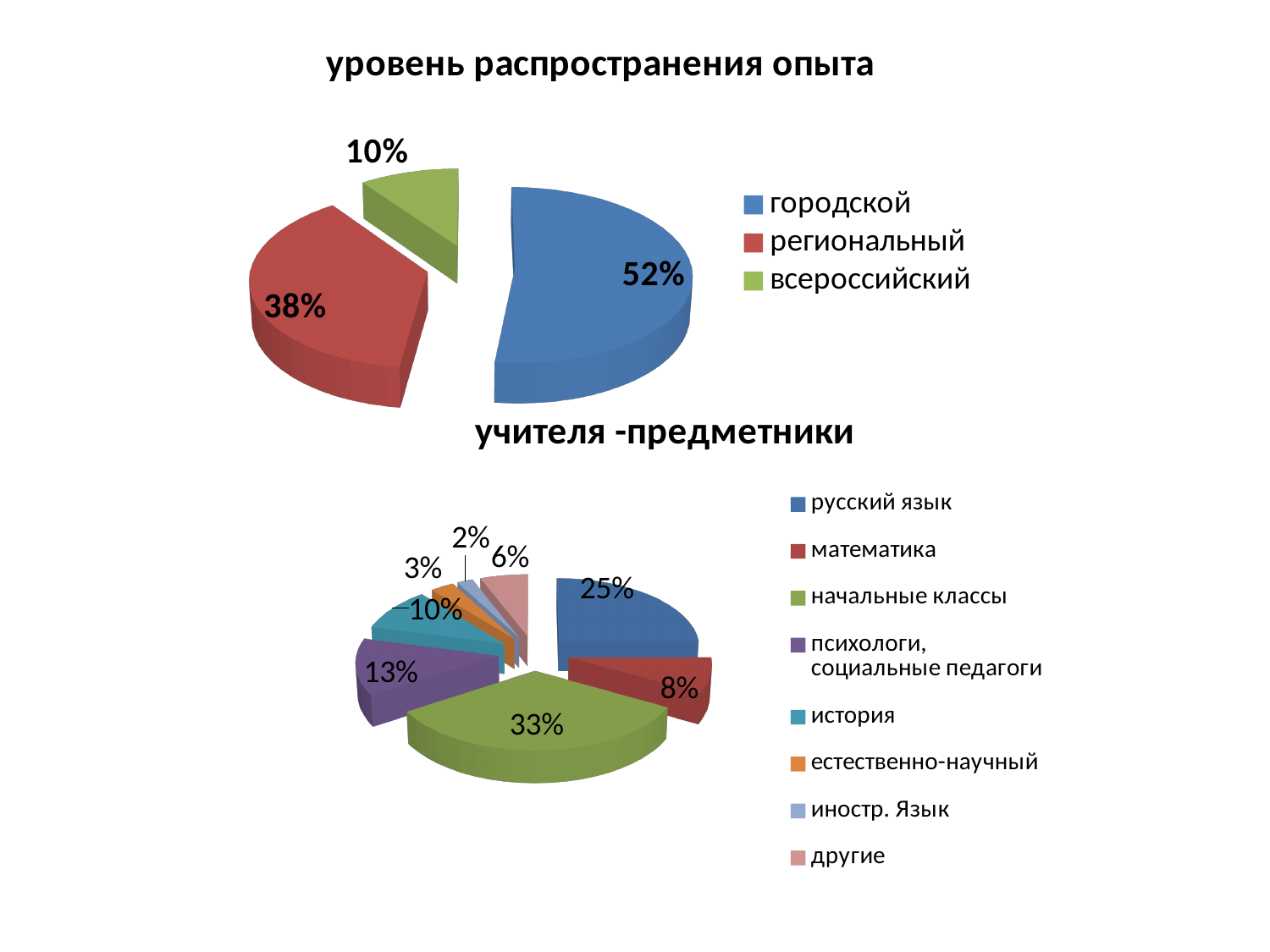
In the chart titled "учителя -предметники", what colour is the slice for "психологи, социальные педагоги"? purple In the chart titled "уровень распространения опыта", what share does "городской" have? 52% In the chart titled "уровень распространения опыта", what share does "всероссийский" have? 10% In the chart titled "учителя -предметники", how many categories does the legend list? 8 In the chart titled "учителя -предметники", what share does "история" have? 10% In the chart titled "учителя -предметники", which category has the smallest slice? иностр. Язык In the chart titled "учителя -предметники", what share does "начальные классы" have? 33% In the chart titled "уровень распространения опыта", which category has the largest slice? городской In the chart titled "уровень распространения опыта", how many categories does the legend list? 3 What type of chart is the chart titled "учителя -предметники"? pie chart In the chart titled "учителя -предметники", which is larger: "русский язык" or "математика"? русский язык In the chart titled "уровень распространения опыта", what is the difference between the shares of "городской" and "региональный"? 14%